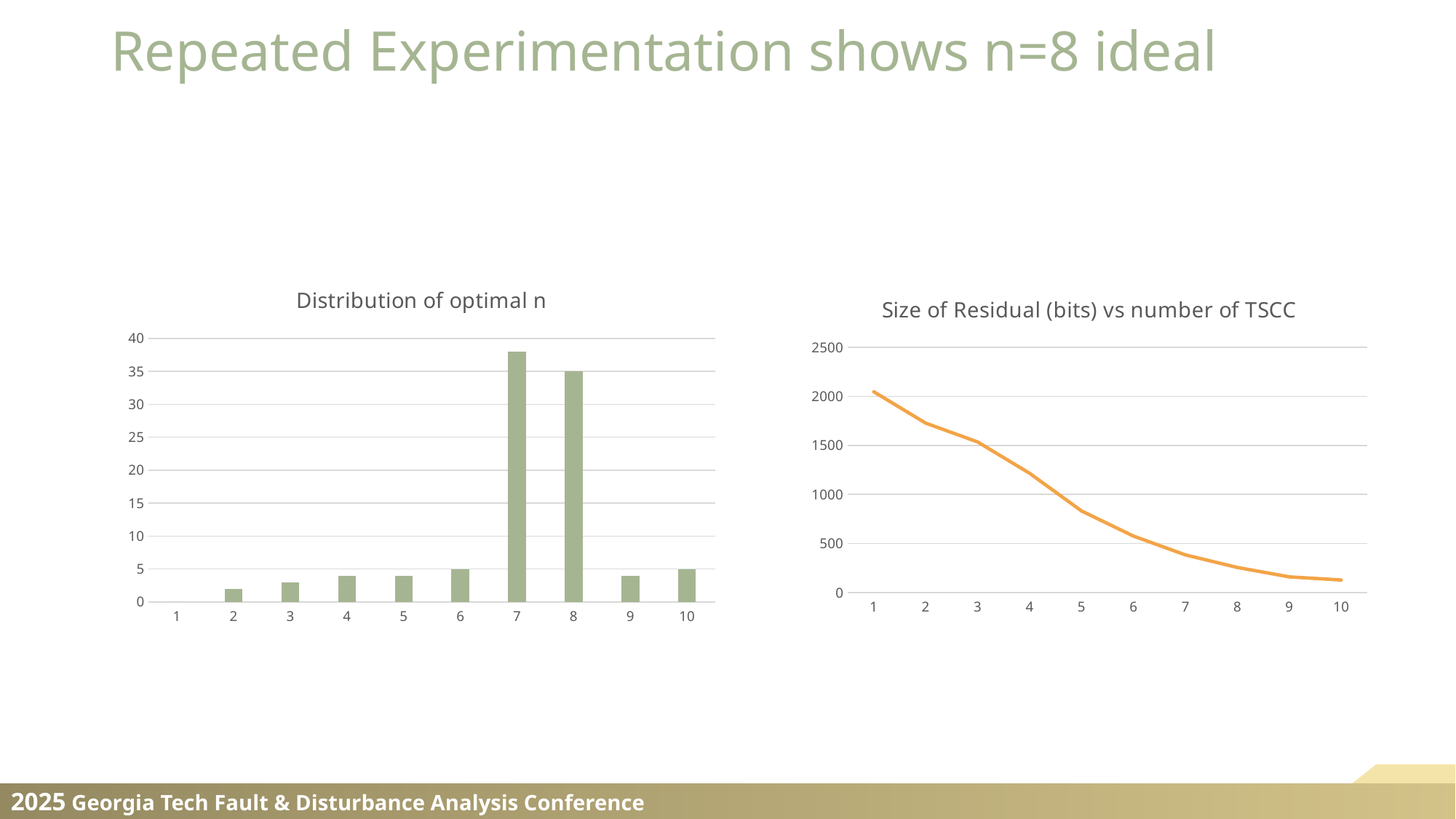
In the 'Size of Residual (bits) vs number of TSCC' chart, do the values rise or fall as the number of TSCC increases? fall What kind of chart is the 'Distribution of optimal n' chart? bar chart In the 'Distribution of optimal n' chart, is the value for category 7 greater or less than 35? greater In the 'Distribution of optimal n' chart, is the value for category 2 greater or less than 5? less In the 'Distribution of optimal n' chart, which is larger, the value for category 7 or the value for category 3? 7 In the 'Size of Residual (bits) vs number of TSCC' chart, how many points are plotted along the x axis? 10 In the 'Distribution of optimal n' chart, which category has the highest bar? 7 In the 'Distribution of optimal n' chart, how many categories are shown on the x axis? 10 In the 'Size of Residual (bits) vs number of TSCC' chart, is the value at 10 greater or less than 500? less What kind of chart is the 'Size of Residual (bits) vs number of TSCC' chart? line chart